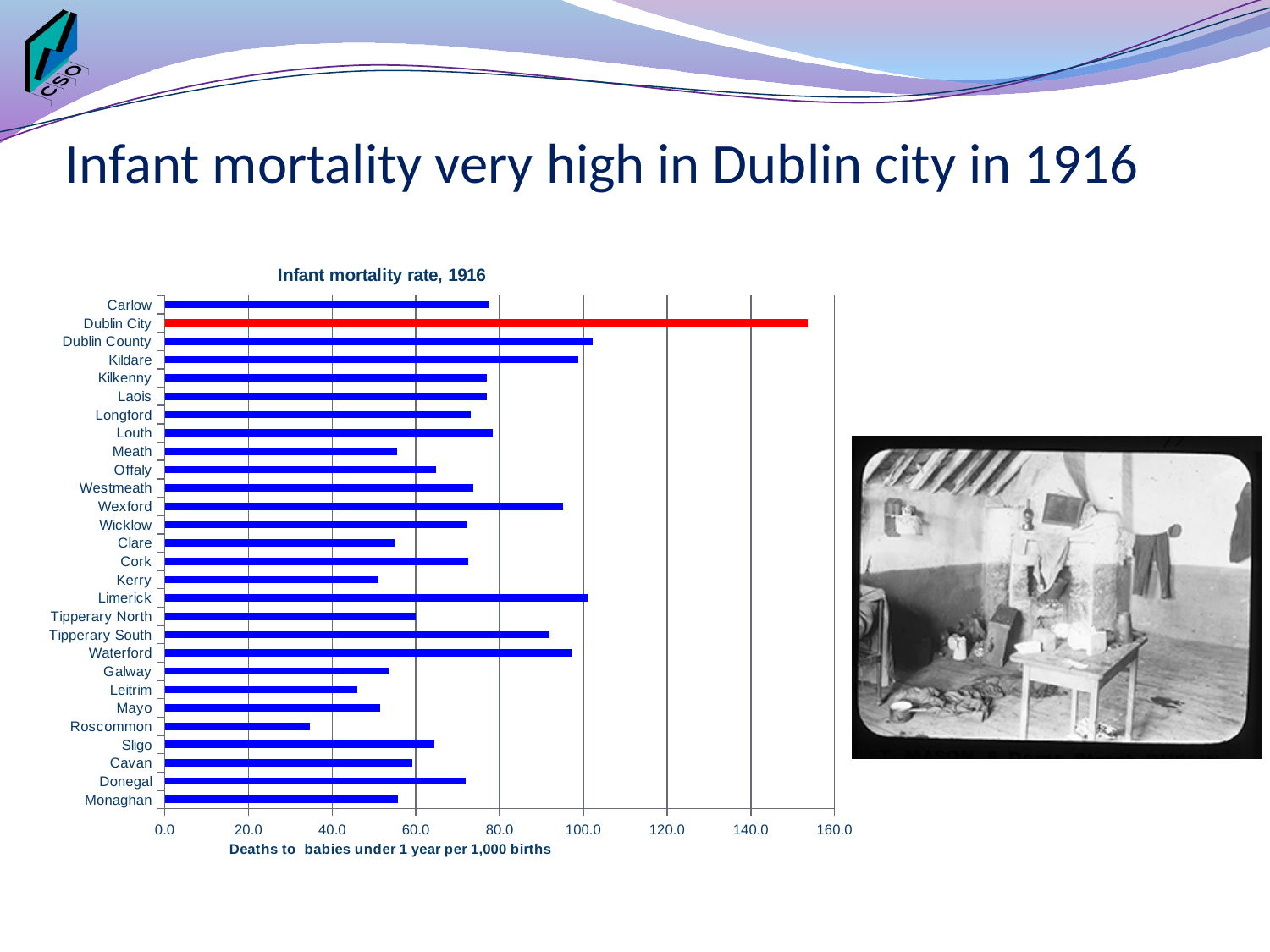
What kind of chart is shown on the slide? Bar chart Is the value for Wexford greater or less than 80? greater Which category has the lowest infant mortality rate in the chart? Roscommon Which has a higher infant mortality rate, Meath or Wexford? Wexford Is the value for Roscommon greater or less than 40? less Which category has the highest infant mortality rate in the chart? Dublin City How many categories are plotted in the chart? 28 Which has a higher infant mortality rate, Limerick or Kerry? Limerick Is the value for Dublin City greater or less than 140? greater What is the title of the chart? Infant mortality rate, 1916 Which bar in the chart is coloured red rather than blue? Dublin City